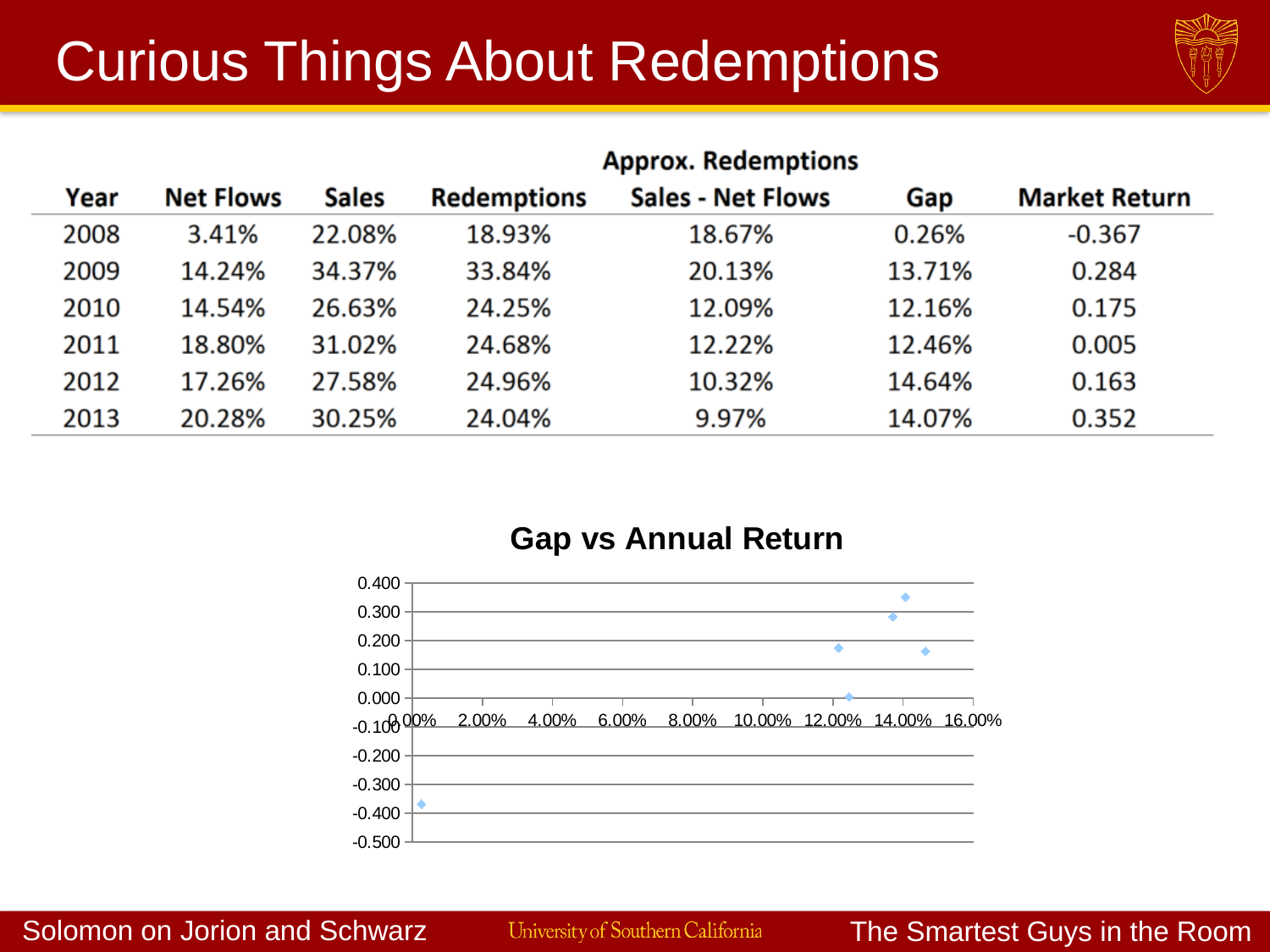
How many data points are plotted in the "Gap vs Annual Return" chart? 6 What is the largest tick label on the horizontal axis of the "Gap vs Annual Return" chart? 16.00% In the "Gap vs Annual Return" chart, is the vertical value of the point with the largest gap greater or less than 0.100? greater In the "Gap vs Annual Return" chart, is the horizontal (gap) value of the lowest point greater or less than 2.00%? less In the "Gap vs Annual Return" chart, is the vertical value of the lowest point greater or less than -0.300? less How many points in the "Gap vs Annual Return" chart have a gap value greater than 10.00%? 5 What kind of chart is "Gap vs Annual Return"? scatter chart What is the title of the chart on the slide? Gap vs Annual Return